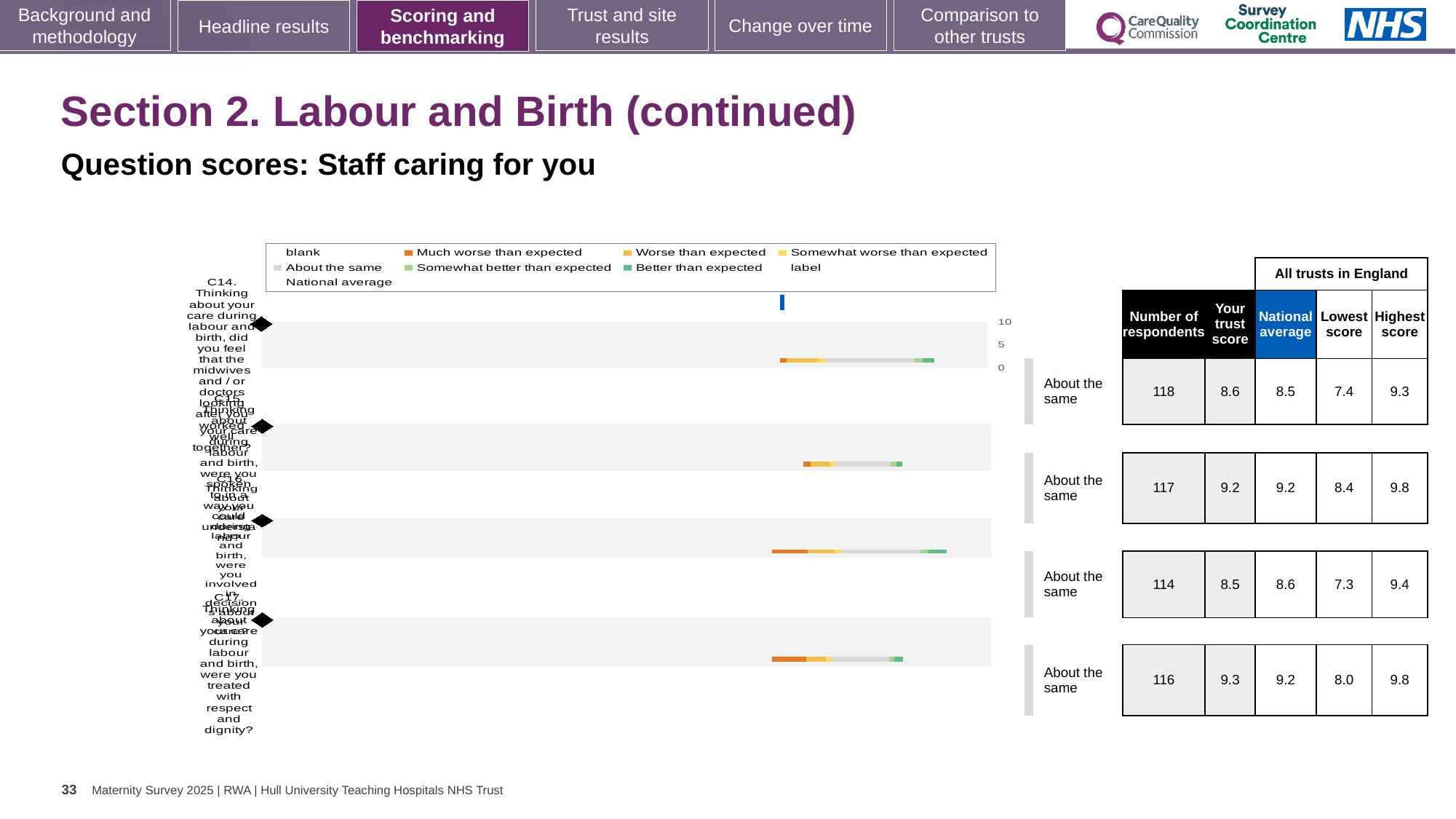
For the top row (C14), which is larger: the trust score or the national average? the trust score (8.6) What colour represents 'Much worse than expected' in the chart legend? orange What benchmark category is shown for every row of the chart? About the same In the table beside the chart, how many respondents are listed for the bottom row (C17, respect and dignity)? 116 Which row has the highest 'Your trust score' in the table beside the chart? the bottom row (C17), 9.3 What colour represents 'Better than expected' in the chart legend? green In the table beside the chart, what is the trust score for the top row (C14, 118 respondents)? 8.6 In the table beside the chart, what is the national average for the top row (C14)? 8.5 For the top row (C14), what is the difference between the highest score (9.3) and the lowest score (7.4) in the table? 1.9 How many question rows (bars) does the chart show? 4 What kind of chart is shown on the slide? bar chart